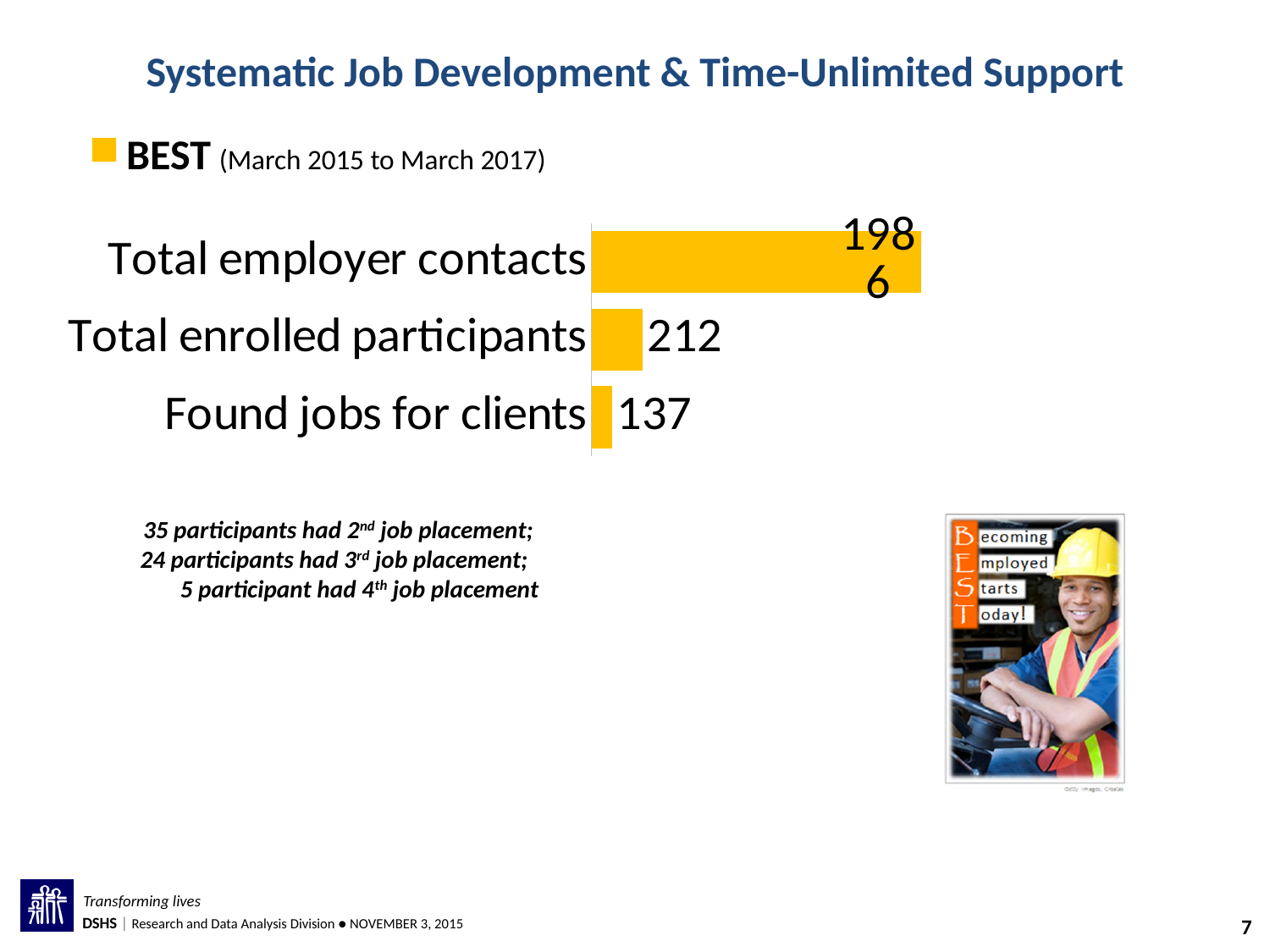
What is the legend entry shown above the chart? BEST (March 2015 to March 2017) What is the value for Total employer contacts? 1986 Which category has the highest value? Total employer contacts How many categories are shown in the chart? 3 What is the value for Found jobs for clients? 137 What colour are the bars in the chart? Yellow Which is larger, Total enrolled participants or Found jobs for clients? Total enrolled participants What is the difference between Total employer contacts and Total enrolled participants? 1774 What is the difference between Total enrolled participants and Found jobs for clients? 75 Which category has the lowest value? Found jobs for clients What is the value for Total enrolled participants? 212 What kind of chart is shown on the slide? Bar chart